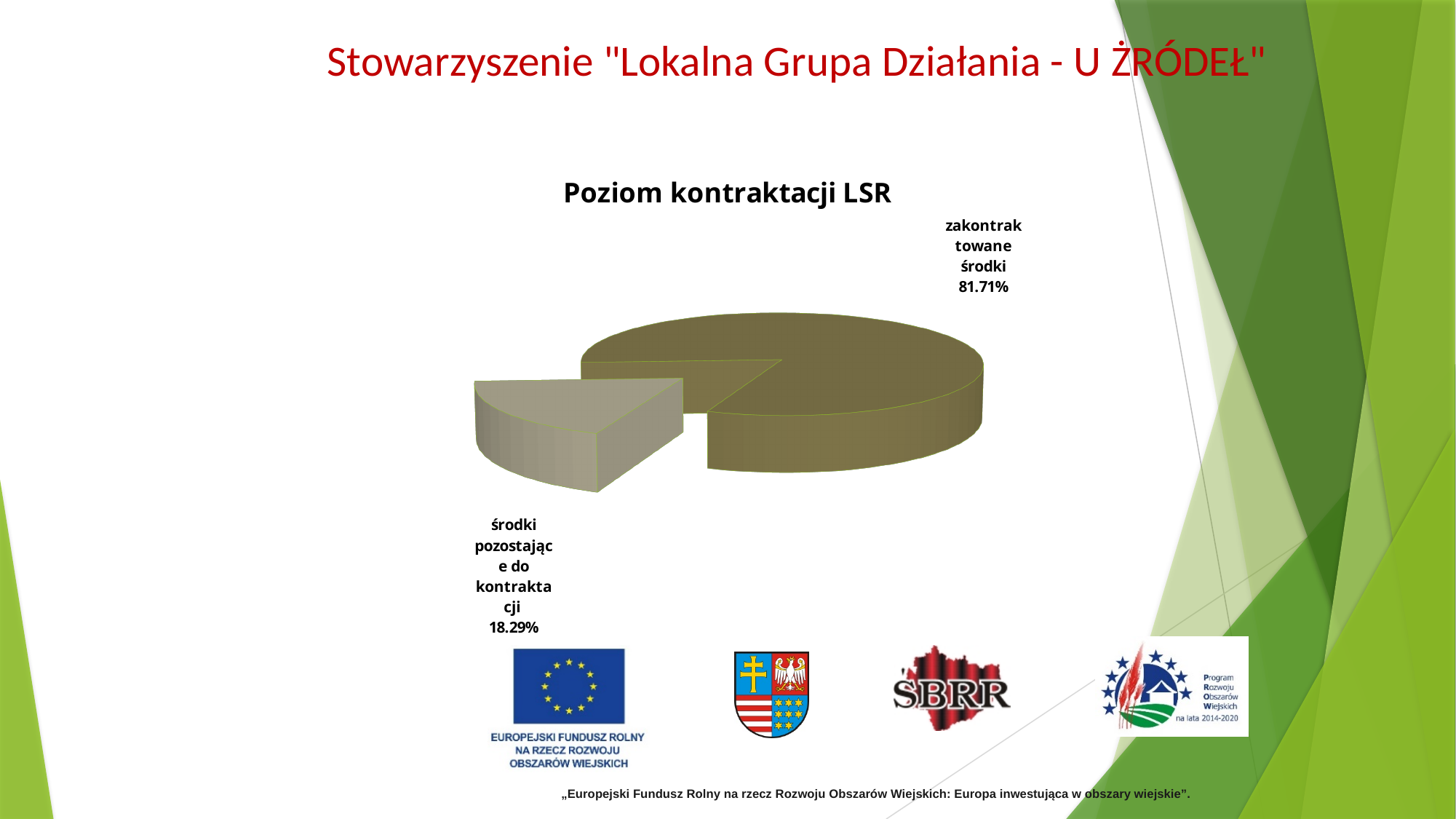
How many slices does the pie chart have? 2 What share of the pie is labelled "środki pozostające do kontraktacji"? 18.29% Which slice of the pie is pulled out (exploded) from the rest of the pie? środki pozostające do kontraktacji What share of the pie is labelled "zakontraktowane środki"? 81.71% Which is larger: the share for "zakontraktowane środki" or the share for "środki pozostające do kontraktacji"? zakontraktowane środki Is the share for "zakontraktowane środki" greater or less than 50%? greater Which slice of the pie is the smallest? środki pozostające do kontraktacji What is the difference in percentage points between the "zakontraktowane środki" slice and the "środki pozostające do kontraktacji" slice? 63.42 Which slice of the pie is the largest? zakontraktowane środki What is the title of the chart? Poziom kontraktacji LSR What kind of chart is shown on the slide? pie chart Is the share for "środki pozostające do kontraktacji" greater or less than 25%? less